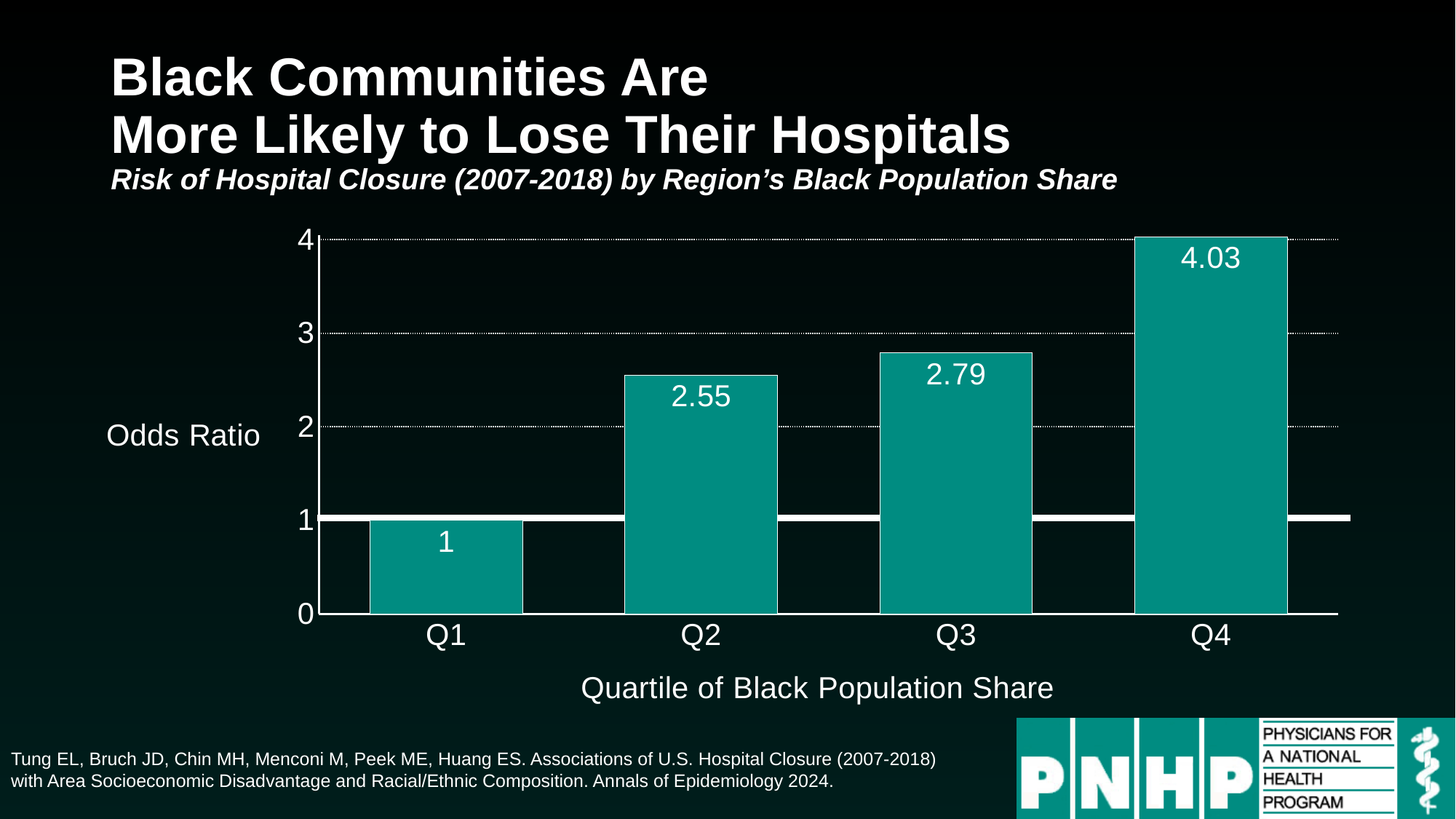
Which has a larger odds ratio, Q2 or Q3? Q3 What is the odds ratio for Q1? 1 What is the odds ratio for Q4? 4.03 How many quartiles are shown on the x axis? 4 Which quartile has the lowest odds ratio? Q1 What kind of chart is shown on the slide? Bar chart What is the odds ratio for Q3? 2.79 Which quartile has the highest odds ratio? Q4 What is the difference between the odds ratios for Q3 and Q2? 0.24 What is the difference between the odds ratios for Q4 and Q1? 3.03 What is the odds ratio for Q2? 2.55 Do the odds ratios rise or fall from Q1 to Q4? Rise